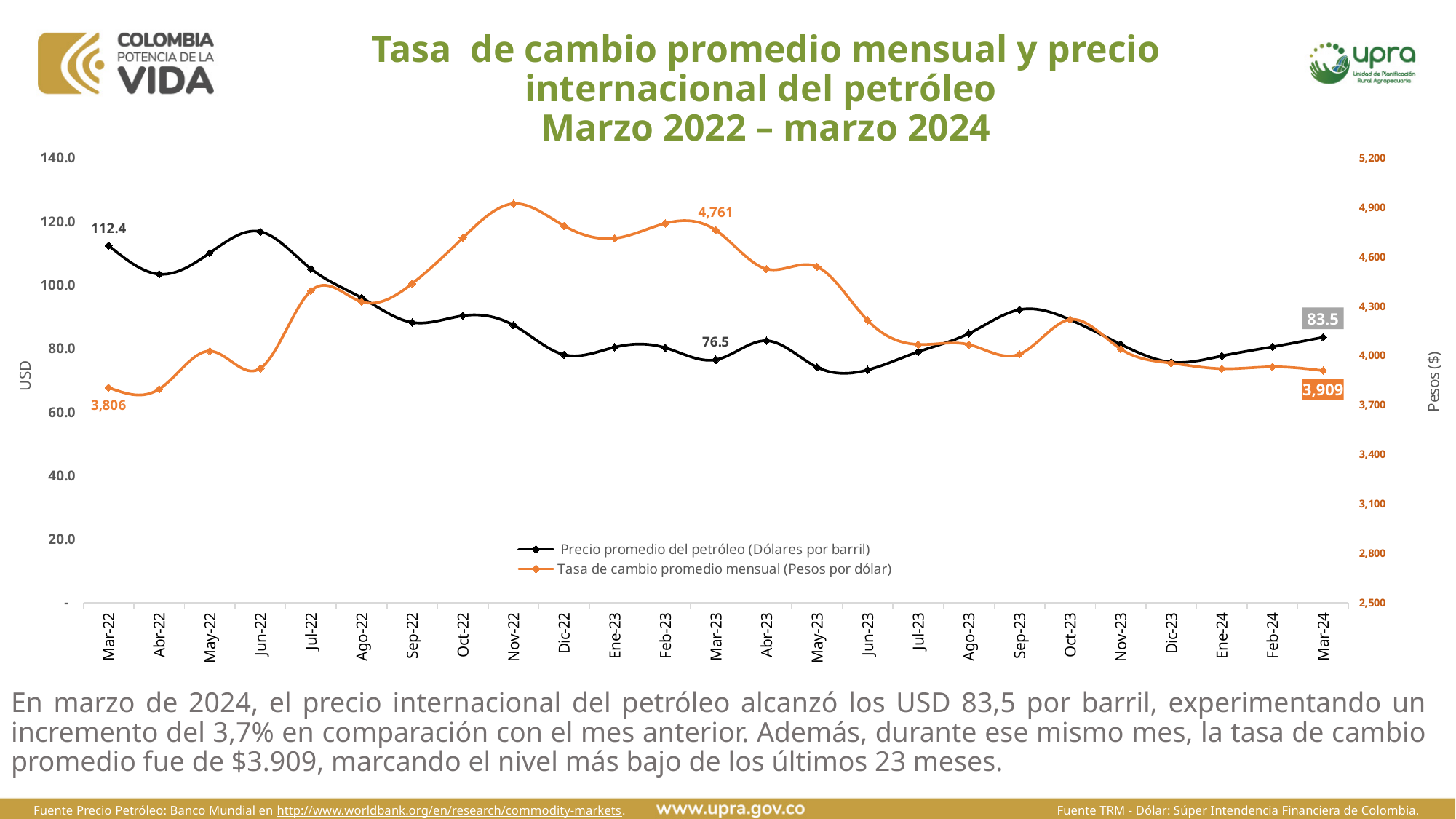
By how much did the average oil price fall between Mar-22 (112.4) and Mar-24 (83.5)? 28.9 What was the average exchange rate (Pesos por dólar) in Mar-24? 3,909 How many months are plotted on the x axis? 25 What is the difference between the exchange rate in Mar-23 (4,761) and in Mar-24 (3,909)? 852 Is the exchange rate in Abr-22 greater or less than 4,000? less In which month does the exchange rate (Pesos por dólar) series reach its highest point? Nov-22 Which of the labelled exchange rate values is lower: Mar-22 or Mar-24? Mar-22 What was the average oil price (Dólares por barril) in Mar-22? 112.4 Is the average oil price in Jun-22 greater or less than 100.0? greater What was the average exchange rate (Pesos por dólar) in Mar-23? 4,761 What was the average oil price (Dólares por barril) in Mar-23? 76.5 How many series does the legend list? 2